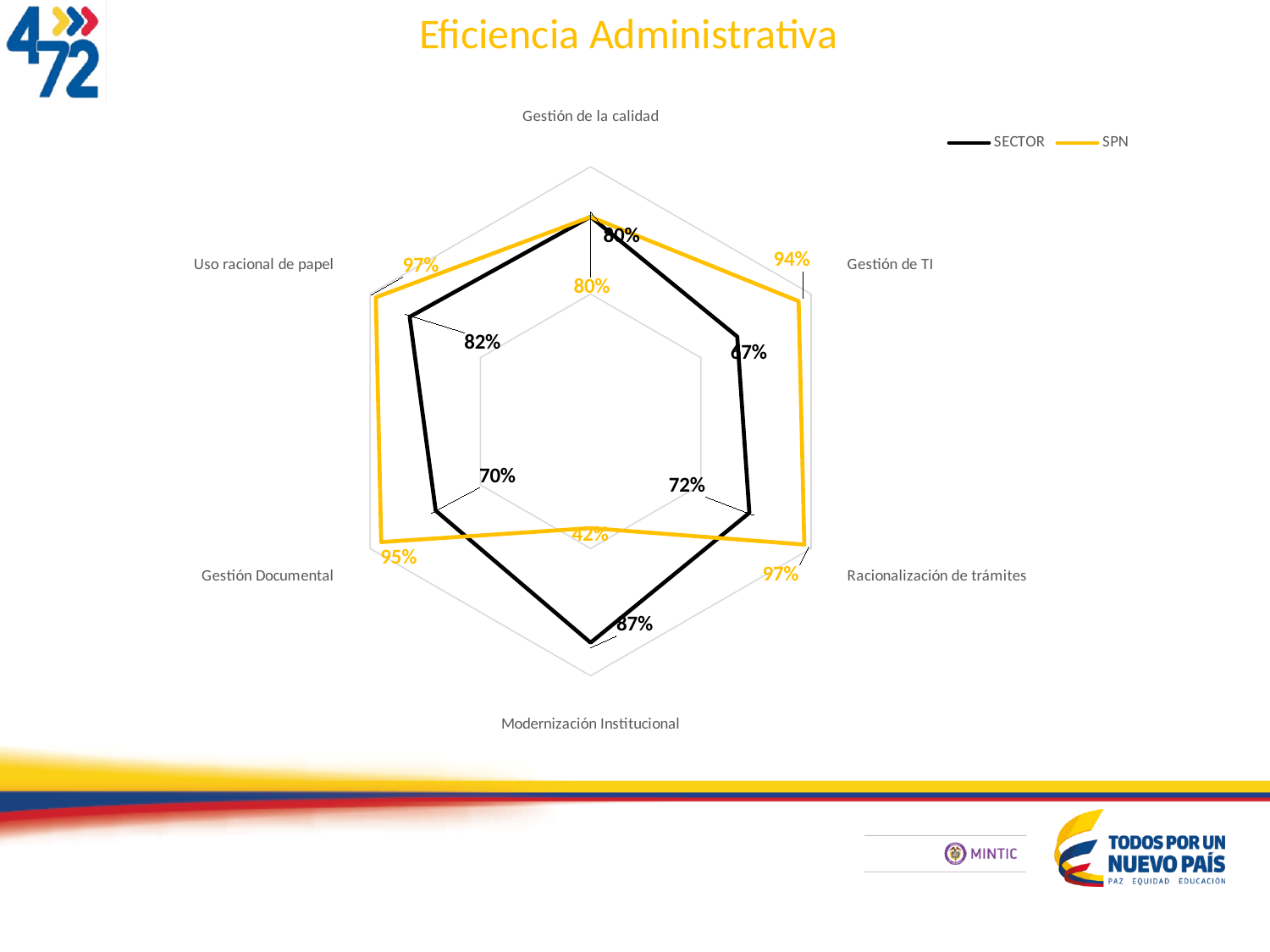
What colour is the SPN series line? Yellow What is the SPN value for Gestión Documental? 95% Which category has the lowest SPN value? Modernización Institucional What is the SECTOR value for Modernización Institucional? 87% How many categories are plotted on the radar chart? 6 Which category has the highest SECTOR value? Modernización Institucional What type of chart is shown on the slide? Radar chart For Modernización Institucional, which series has the larger value, SECTOR or SPN? SECTOR What is the SPN value for Racionalización de trámites? 97% What is the difference between the SPN and SECTOR values for Gestión de TI? 27% What is the SECTOR value for Gestión de TI? 67% How many series does the legend list? 2